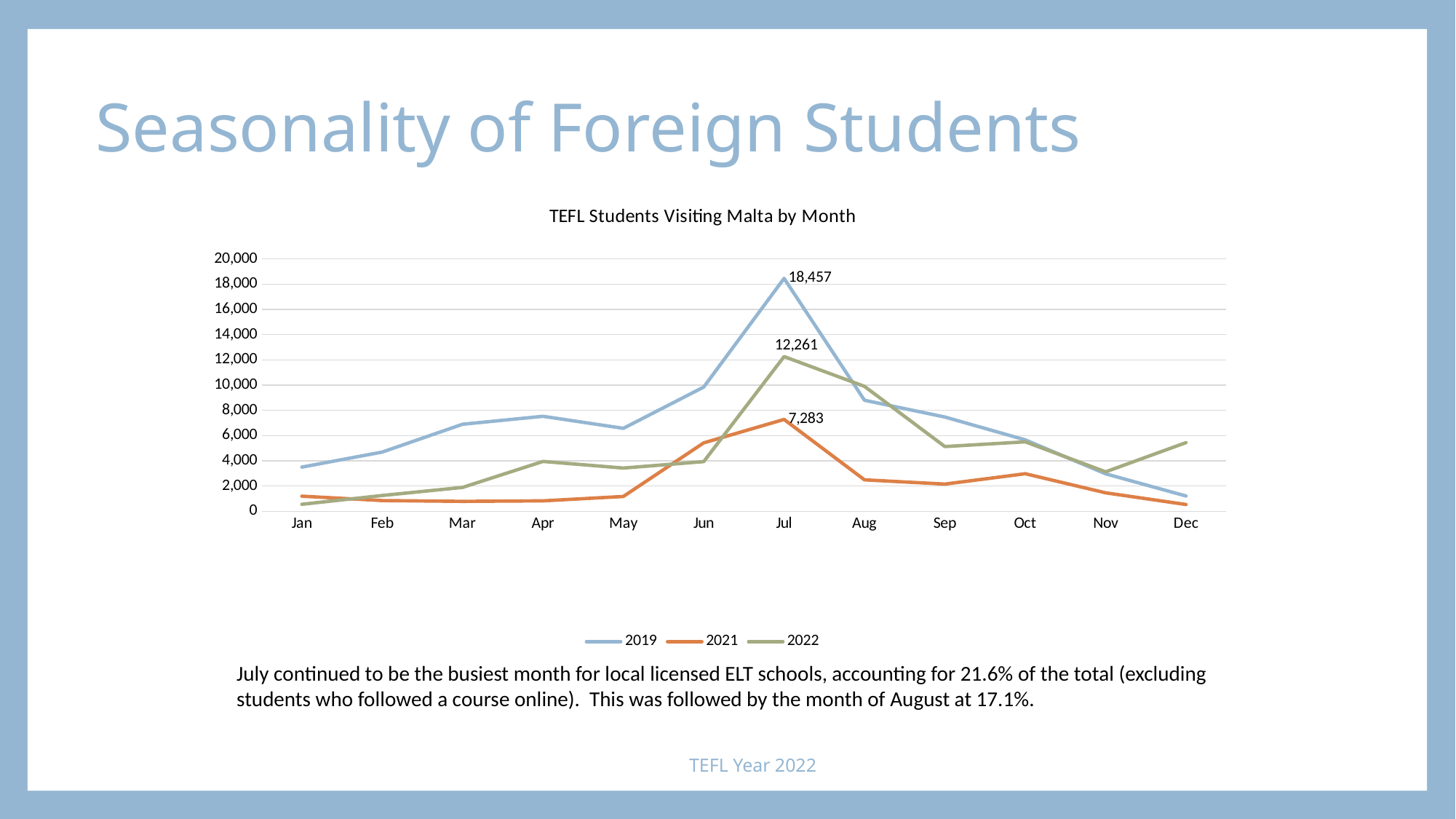
In Jul, which series has the larger value, 2019 or 2021? 2019 What is the value for 2021 in Jul? 7,283 Is the value for 2022 in Dec greater or less than 4,000? greater What is the value for 2019 in Jul? 18,457 Which month has the highest value for the 2019 series? Jul Do the values for the 2019 series rise or fall from Jul to Dec? fall What is the title of the chart? TEFL Students Visiting Malta by Month What is the difference between the 2019 and 2022 values in Jul? 6,196 What is the value for 2022 in Jul? 12,261 How many series does the legend list? 3 What type of chart is shown on the slide? Line chart How many months are shown on the x axis? 12